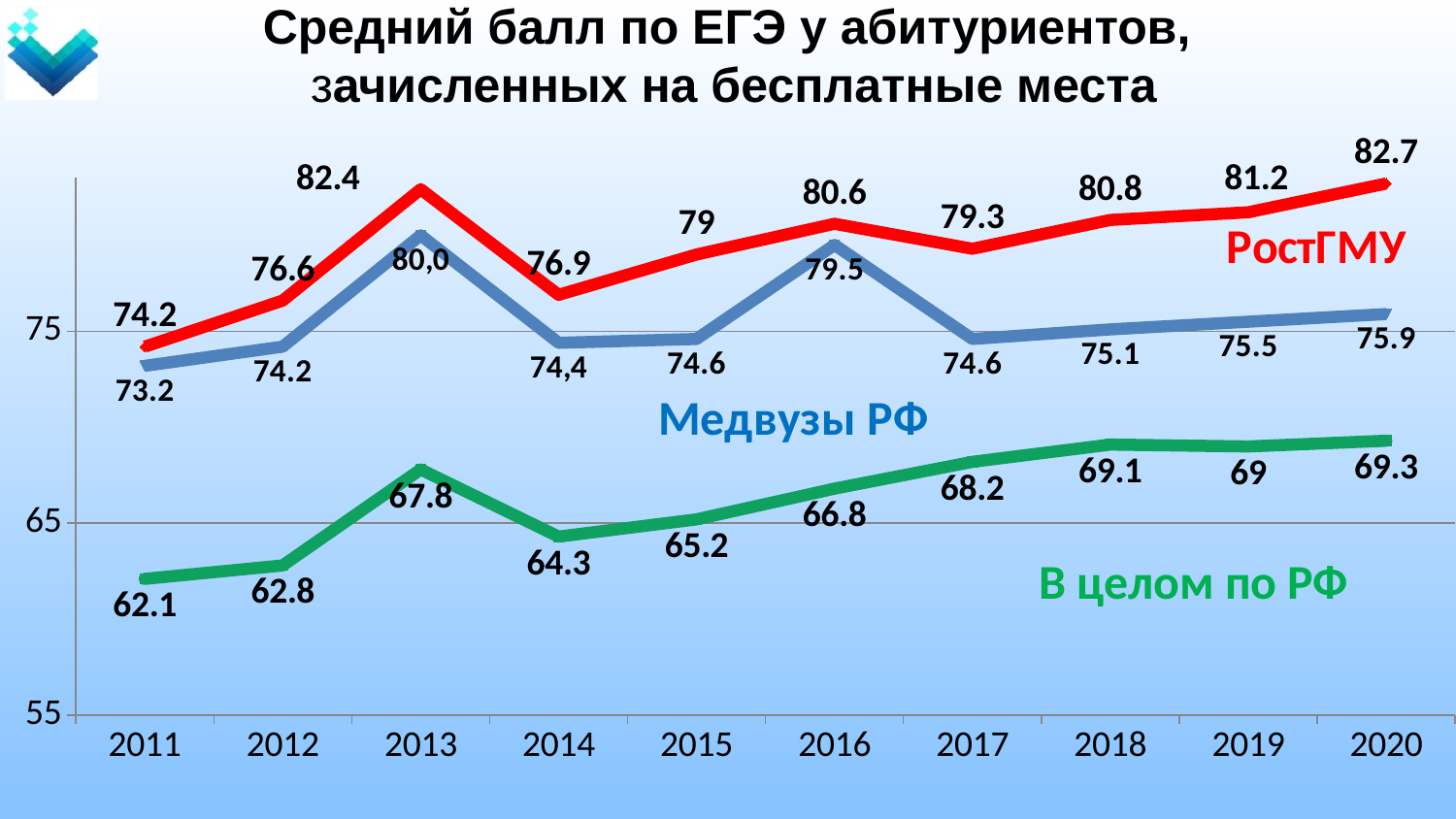
In which year is the value for В целом по РФ lowest? 2011 How many years are shown on the x axis? 10 What is the value for В целом по РФ in 2011? 62.1 What is the value for РостГМУ in 2020? 82.7 In which year is the value for РостГМУ highest? 2020 What is the value for Медвузы РФ in 2013? 80,0 Does the value for В целом по РФ rise or fall from 2011 to 2013? rise What type of chart is shown on the slide? line chart What is the difference between РостГМУ and В целом по РФ in 2020? 13.4 What is the value for Медвузы РФ in 2019? 75.5 How many series are plotted on the chart? 3 Which is larger in 2016: the value for РостГМУ or the value for Медвузы РФ? РостГМУ